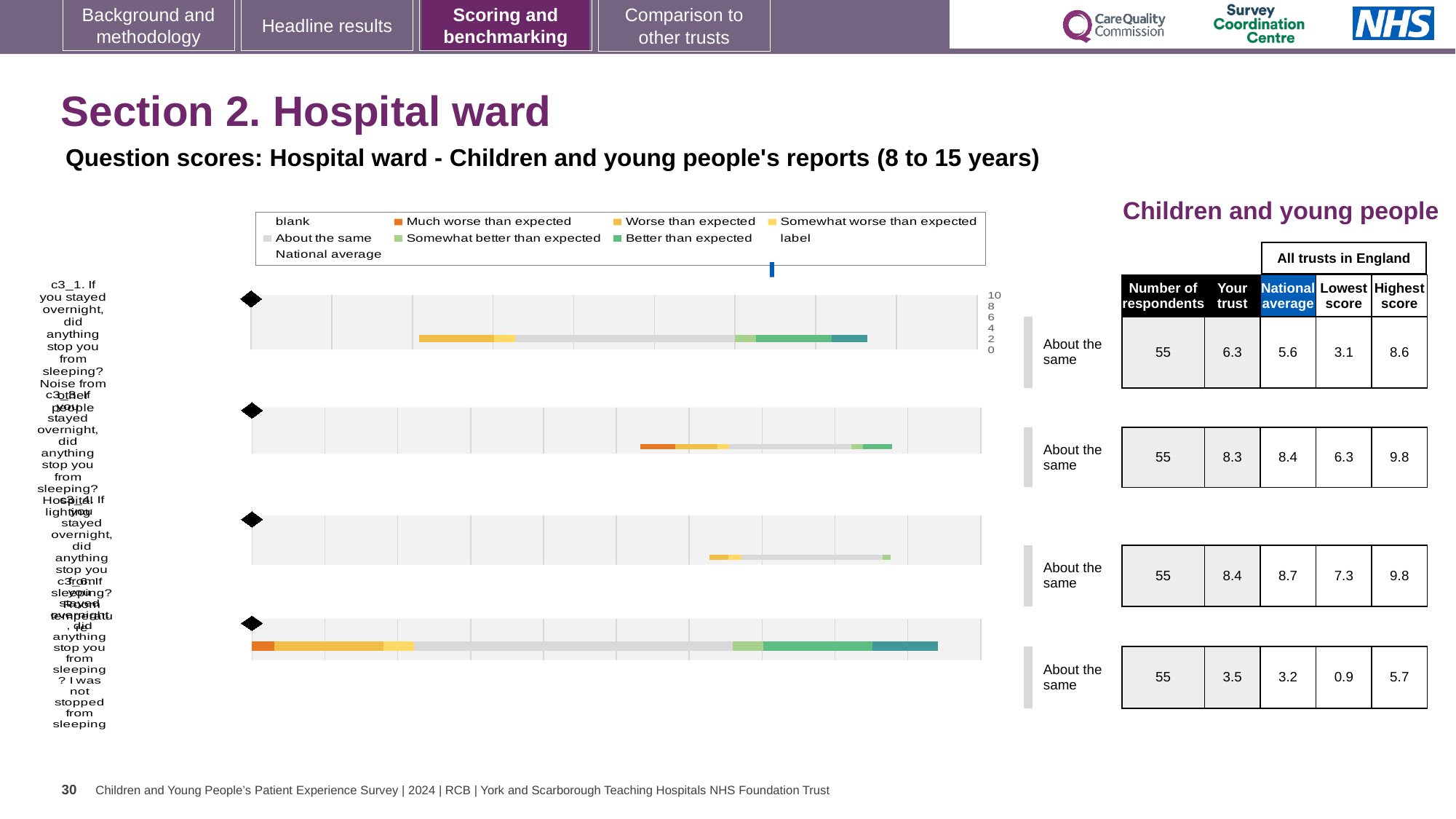
What is the national average for the first question (c3_1, noise from other people)? 5.6 For the third question, is the 'Your trust' score (8.4) higher or lower than the national average (8.7)? Lower How many questions (bars) are plotted in the benchmarking chart? 4 Which of the four questions has the lowest 'Your trust' score? c3_6 (I was not stopped from sleeping), 3.5 What is the difference between the 'Your trust' score and the national average for the first question (c3_1)? 0.7 Which of the four questions has the highest 'Your trust' score? The third question, 8.4 How many respondents answered each of the four questions shown? 55 What kind of chart is used to show the benchmarking bands for each question? Bar chart What benchmark category is shown next to each of the four questions? About the same What is the lowest score across all trusts in England for the second question (hospital lighting)? 6.3 What is the highest score across all trusts in England for the last question (c3_6, I was not stopped from sleeping)? 5.7 What is the 'Your trust' score for the first question (c3_1, noise from other people)? 6.3